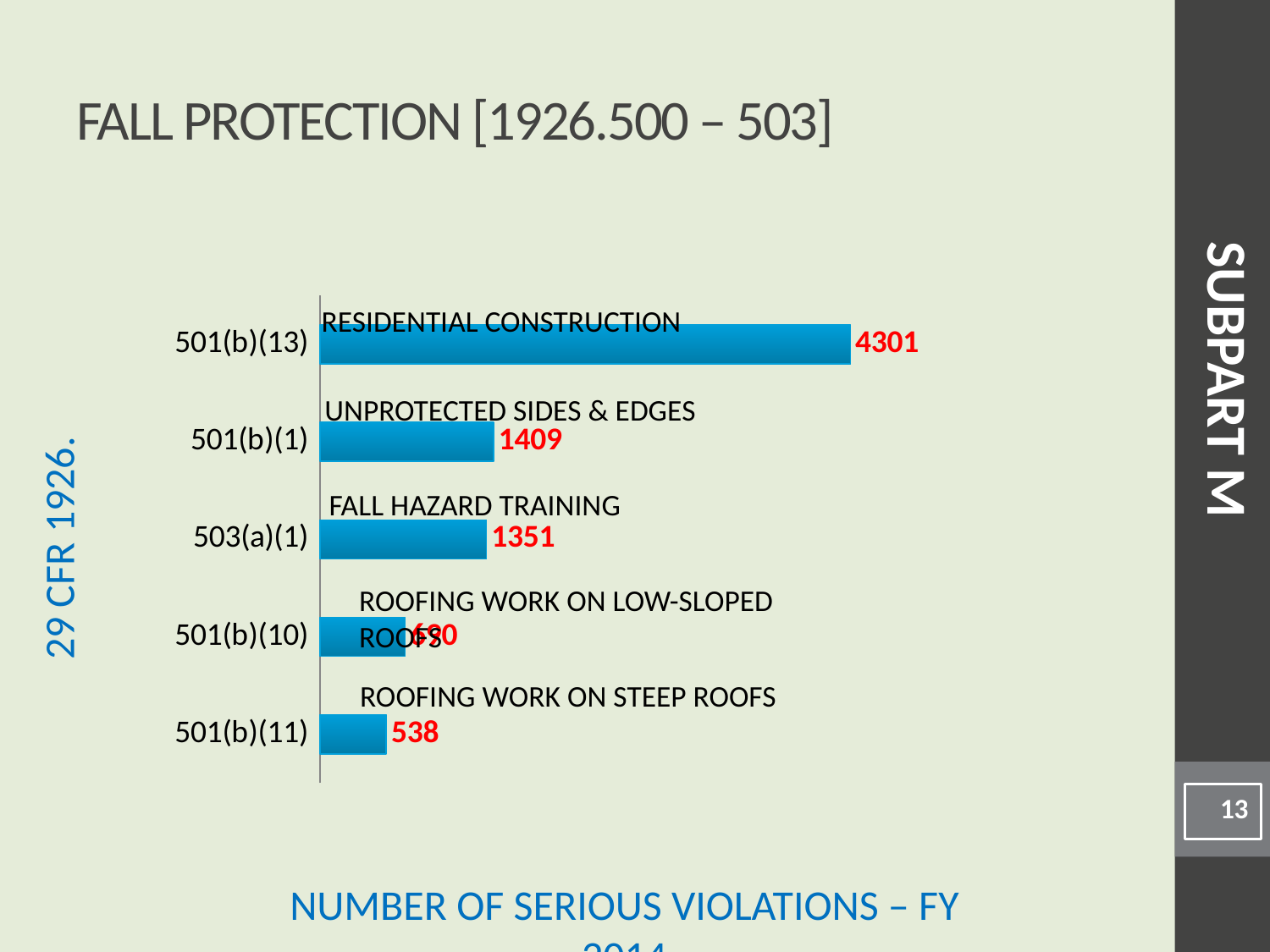
What is the number of serious violations for 501(b)(13)? 4301 How many standards (bars) are shown in the chart? 5 Which standard has the lowest number of serious violations? 501(b)(11) Which has a larger value, 501(b)(1) or 503(a)(1)? 501(b)(1) What value is shown for 503(a)(1), Fall Hazard Training? 1351 What is the difference between the values for 501(b)(13) and 501(b)(1)? 2892 What is the difference between the values for 501(b)(1) and 503(a)(1)? 58 What value is shown for 501(b)(1), Unprotected Sides & Edges? 1409 Which standard has the highest number of serious violations? 501(b)(13) What description is written on the bar for 501(b)(13)? RESIDENTIAL CONSTRUCTION What value is shown for 501(b)(11), Roofing Work on Steep Roofs? 538 What type of chart is shown on the slide? Bar chart